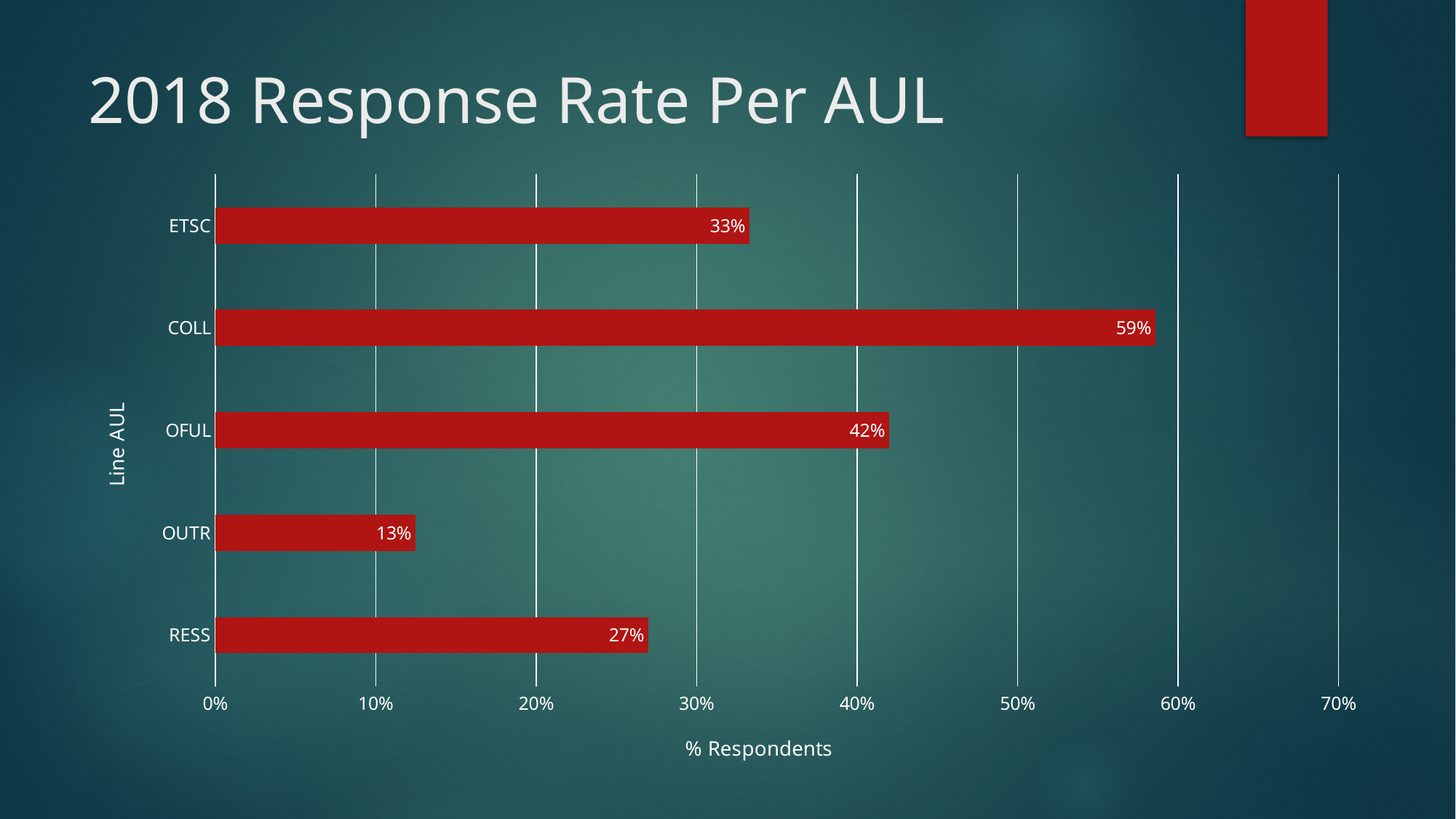
Which Line AUL has the highest response rate? COLL Is the value for OFUL greater or less than 40%? greater What is the label of the horizontal axis? % Respondents What is the response rate for COLL? 59% How many Line AULs are shown in the chart? 5 Which has a higher response rate, OFUL or ETSC? OFUL What is the response rate for OUTR? 13% Which Line AUL has the lowest response rate? OUTR What is the difference between the response rates of ETSC and RESS? 6% What kind of chart is shown on the slide? bar chart What is the difference between the response rates of COLL and OFUL? 17% What is the response rate for RESS? 27%